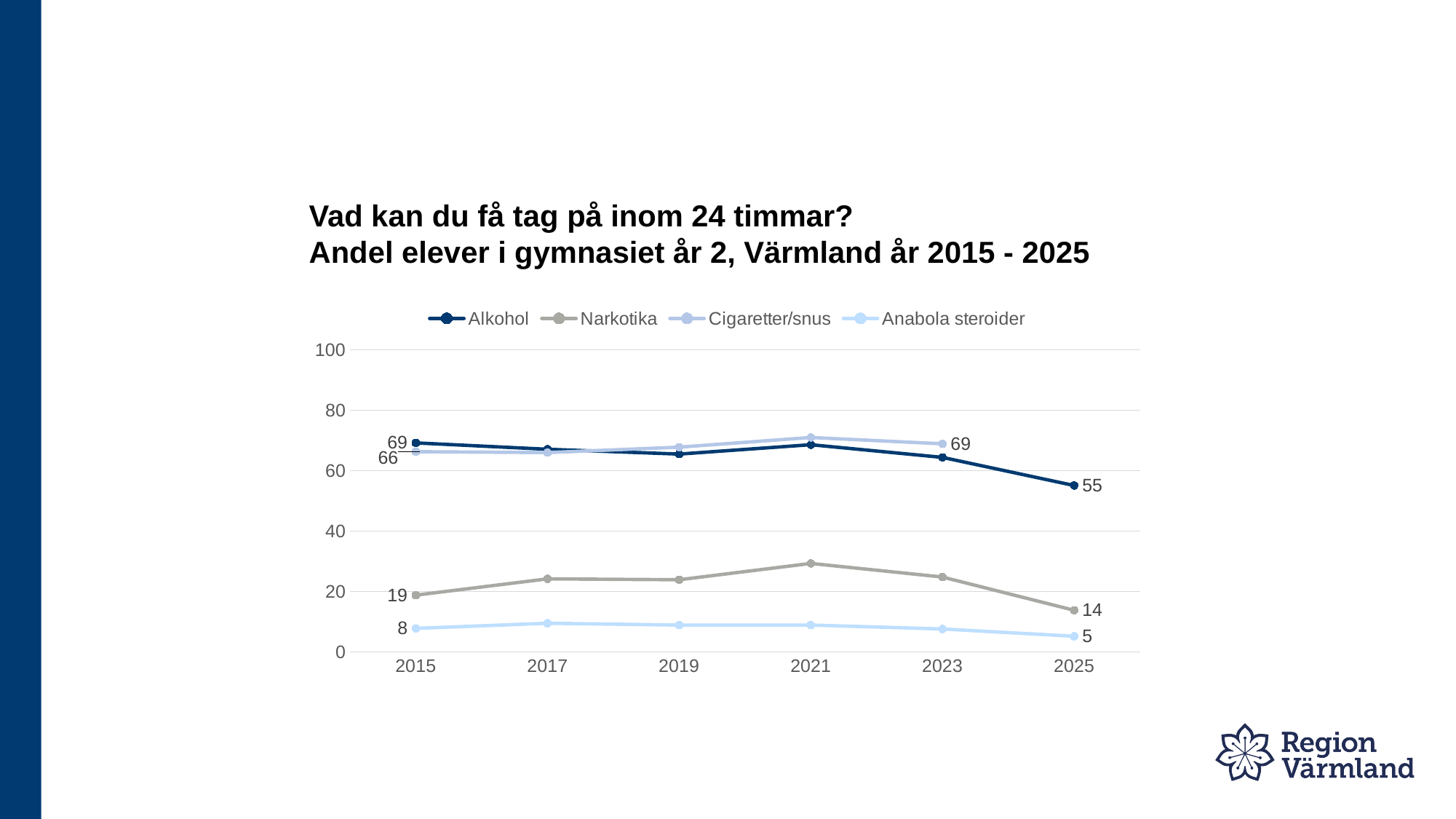
What is the value for Cigaretter/snus in 2015? 66 What kind of chart is shown on the slide? Line chart What is the value for Narkotika in 2025? 14 What is the value for Alkohol in 2025? 55 Is the value for Narkotika in 2021 greater or less than 20? greater What is the value for Narkotika in 2015? 19 What is the value for Anabola steroider in 2025? 5 What is the value for Alkohol in 2015? 69 By how much did the value for Alkohol fall from 2015 to 2025? 14 How many years are shown on the x axis? 6 Which series has the lowest value in 2025? Anabola steroider How many series does the legend list? 4